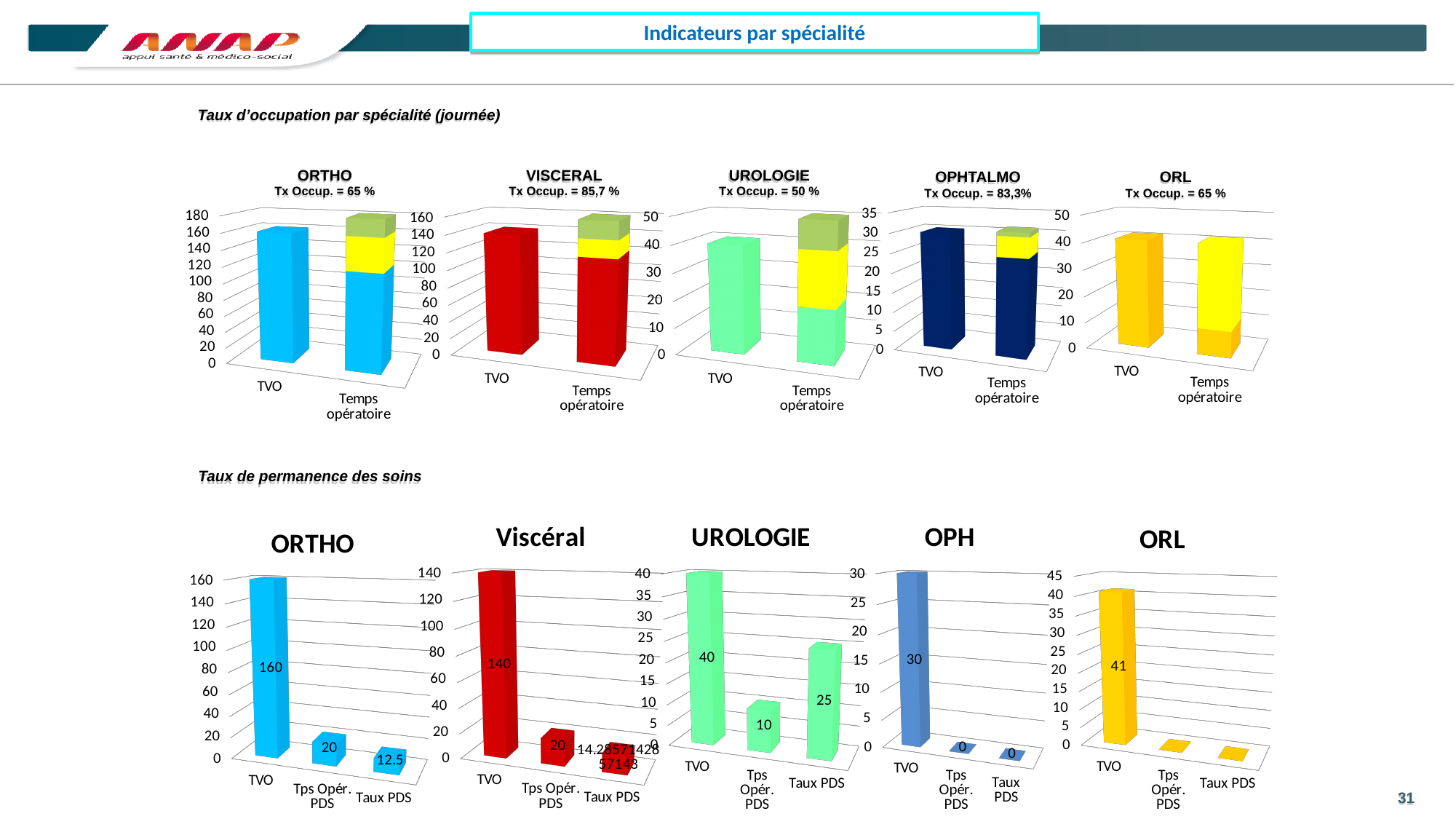
In the bottom OPH chart, what is the value for Tps Opér. PDS? 0 In the bottom Viscéral chart, what is the value for TVO? 140 In the bottom ORTHO chart, what is the value for Taux PDS? 12.5 In the bottom ORTHO chart, what is the value for TVO? 160 In the bottom ORL chart, what is the value for TVO? 41 In the bottom UROLOGIE chart, what is the value for Taux PDS? 25 In the bottom UROLOGIE chart, which category has the lowest value? Tps Opér. PDS In the top VISCERAL chart, what Tx Occup. value is given in the chart title? 85,7 % In the bottom UROLOGIE chart, what is the difference between the TVO value and the Tps Opér. PDS value? 30 How many categories are shown on the x axis of the bottom ORTHO chart? 3 In the bottom ORTHO chart, which category has the highest value? TVO What kind of chart is the bottom Viscéral chart? Bar chart